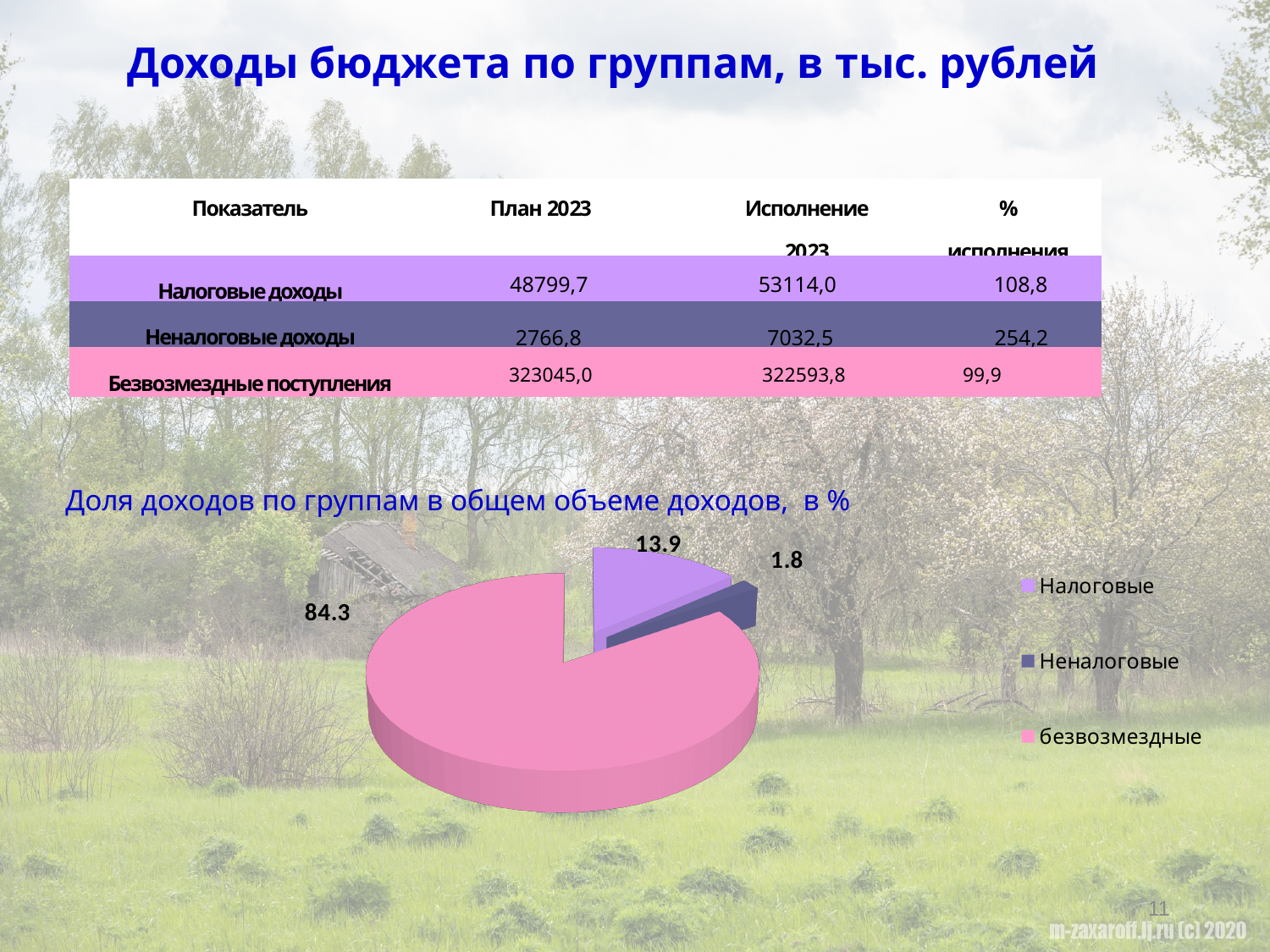
What is the difference between the values for безвозмездные and Налоговые in the pie chart? 70.4 Which category has the smallest slice in the pie chart? Неналоговые What is the value for Неналоговые in the pie chart? 1.8 What is the value for Налоговые in the pie chart? 13.9 How many entries does the legend of the pie chart list? 3 What colour is the безвозмездные slice in the pie chart? pink What is the title of the pie chart? Доля доходов по группам в общем объеме доходов, в % What is the value for безвозмездные in the pie chart? 84.3 How many slices does the pie chart have? 3 What kind of chart is shown on the slide? pie chart Which category has the largest slice in the pie chart? безвозмездные Which is larger in the pie chart, Налоговые or Неналоговые? Налоговые